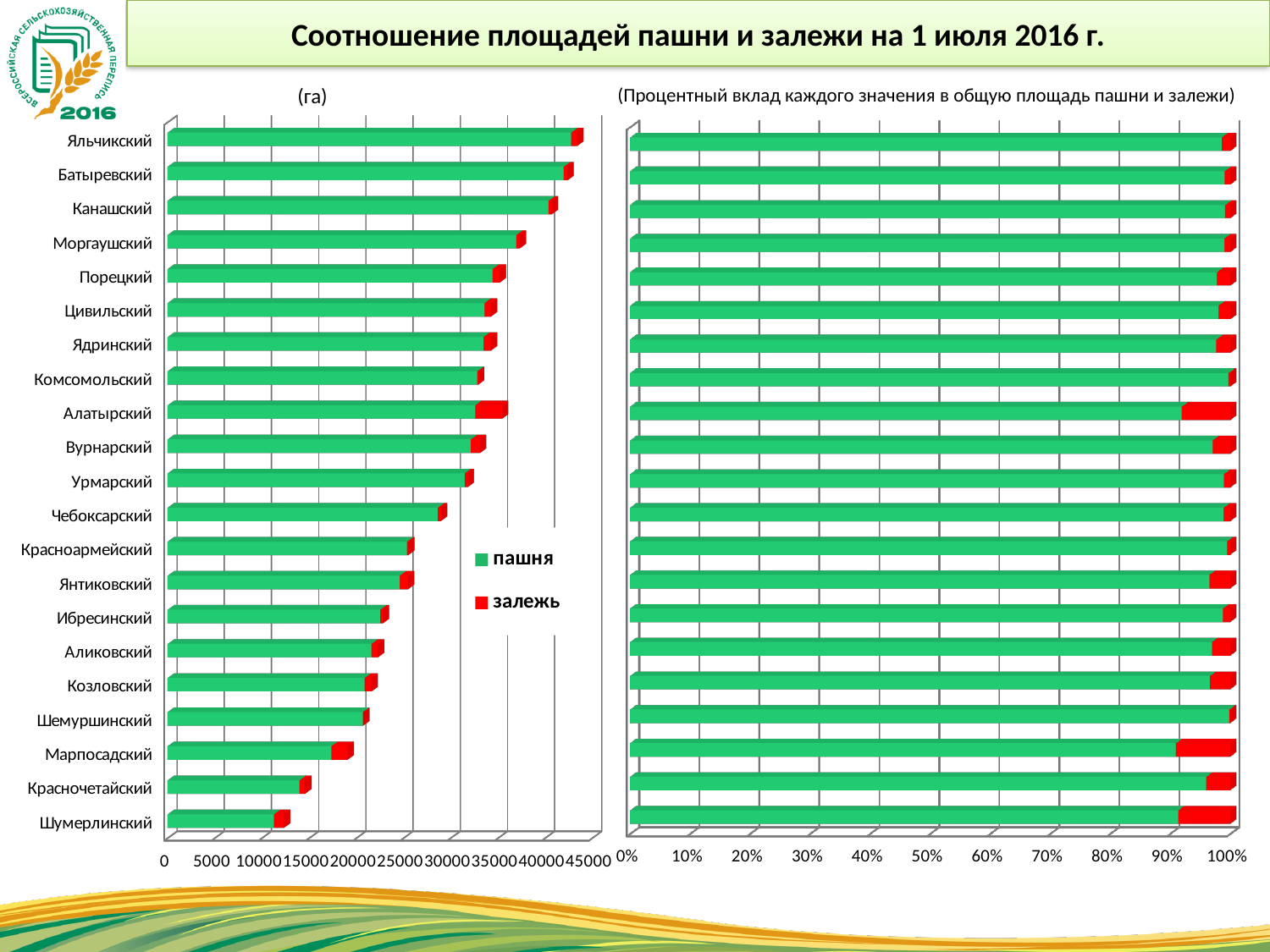
On the left chart "(га)", is the пашня value for Марпосадский greater or less than 20000? less On the left chart "(га)", is the пашня value for Чебоксарский greater or less than 25000? greater On the right chart, is the пашня share for Шумерлинский greater or less than 80%? greater How many series does the legend of the left chart "(га)" list? 2 How many districts (categories) are shown on the left chart "(га)"? 21 On the left chart "(га)", which district has the smallest пашня area? Шумерлинский On the left chart "(га)", which district has a larger пашня area, Батыревский or Козловский? Батыревский What kind of chart is the left chart titled "(га)"? bar chart Which series is shown in red on the charts? залежь On the left chart "(га)", which district has the largest пашня area? Яльчикский